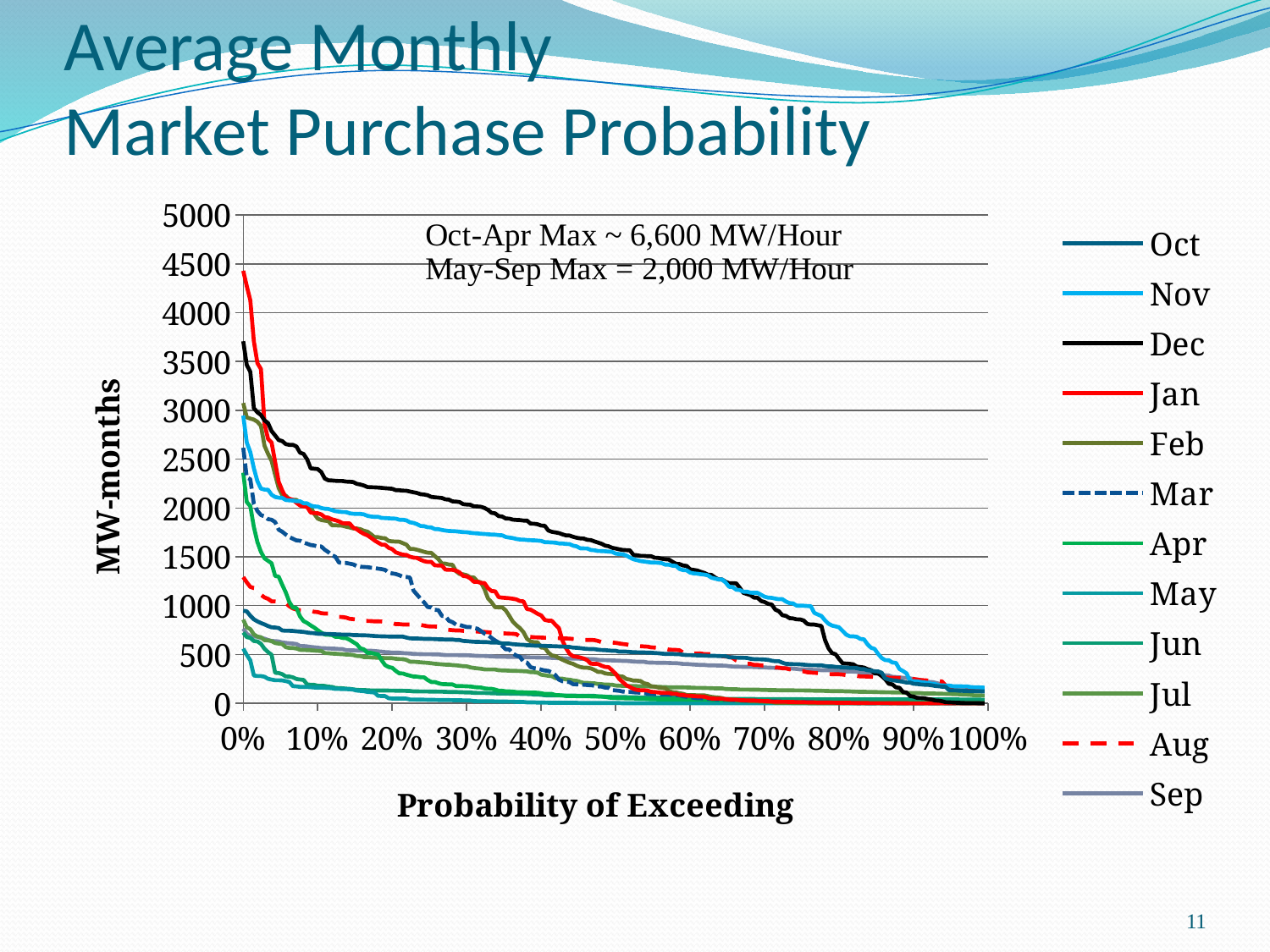
At 80% probability of exceeding, which is larger, the value for Nov or the value for Dec? Nov Is the value for Dec at 0% probability of exceeding greater or less than 3500? greater Is the value for Jan at 50% probability of exceeding greater or less than 500? less What kind of chart is shown on the slide? Line chart Do the series values rise or fall as the probability of exceeding increases along the x axis? Fall Is the value for Dec at 50% probability of exceeding greater or less than 1500? greater According to the annotation on the chart, what is the May-Sep Max? 2,000 MW/Hour What is the title of the x axis? Probability of Exceeding How many series does the legend list? 12 Which series has the highest value at 0% probability of exceeding? Jan